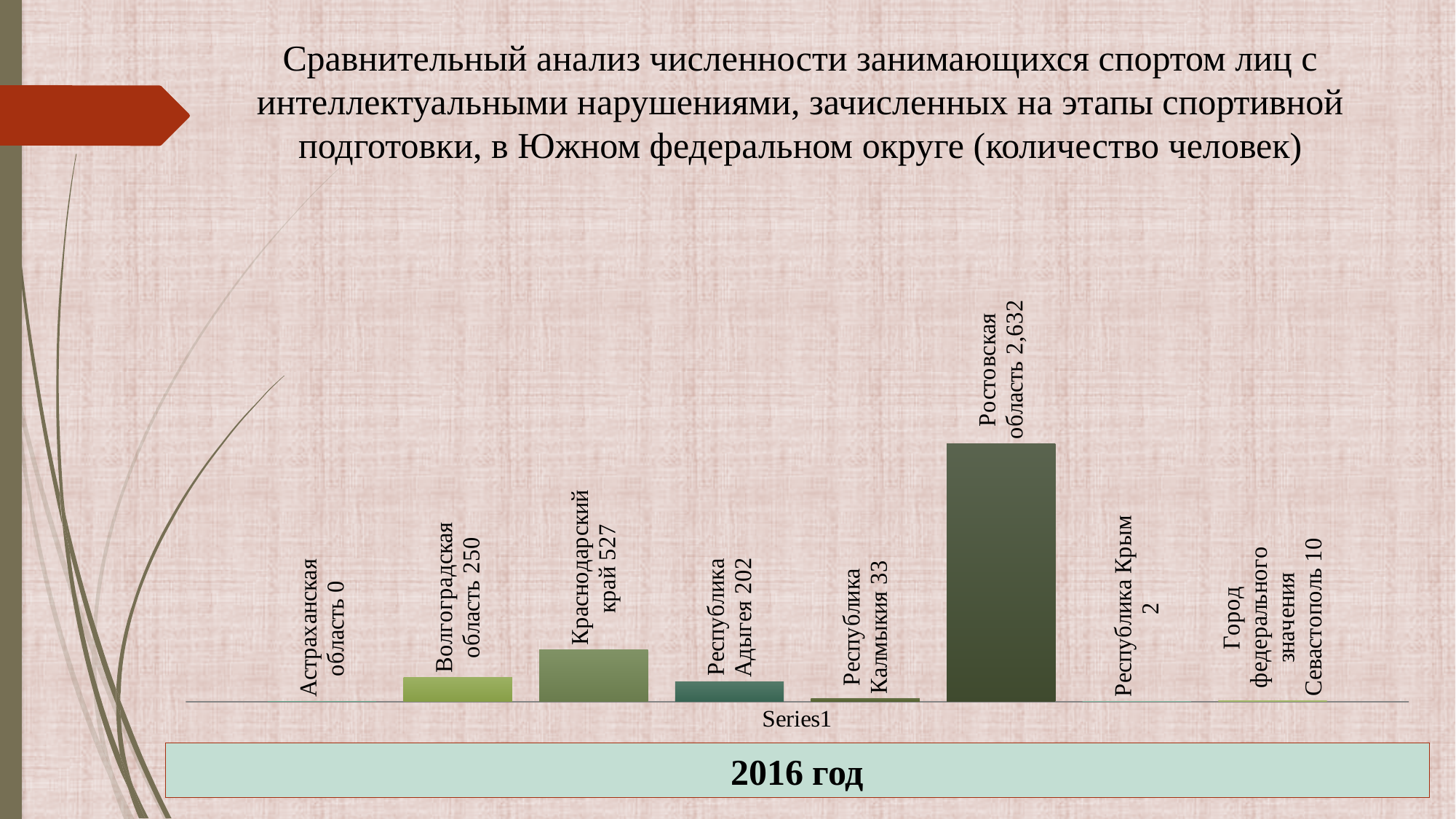
What kind of chart is shown on the slide? Bar chart How many regions are shown in the chart? 8 What is the value for Республика Калмыкия? 33 What is the value for Ростовская область? 2,632 What is the value for Краснодарский край? 527 Which year does the chart refer to, according to the label below it? 2016 год Which is larger, the value for Республика Адыгея or the value for Волгоградская область? Волгоградская область What is the difference between the values for Краснодарский край and Волгоградская область? 277 What is the difference between the values for Ростовская область and Краснодарский край? 2,105 What is the value for Город федерального значения Севастополь? 10 Which region has the lowest value? Астраханская область Which region has the highest value? Ростовская область